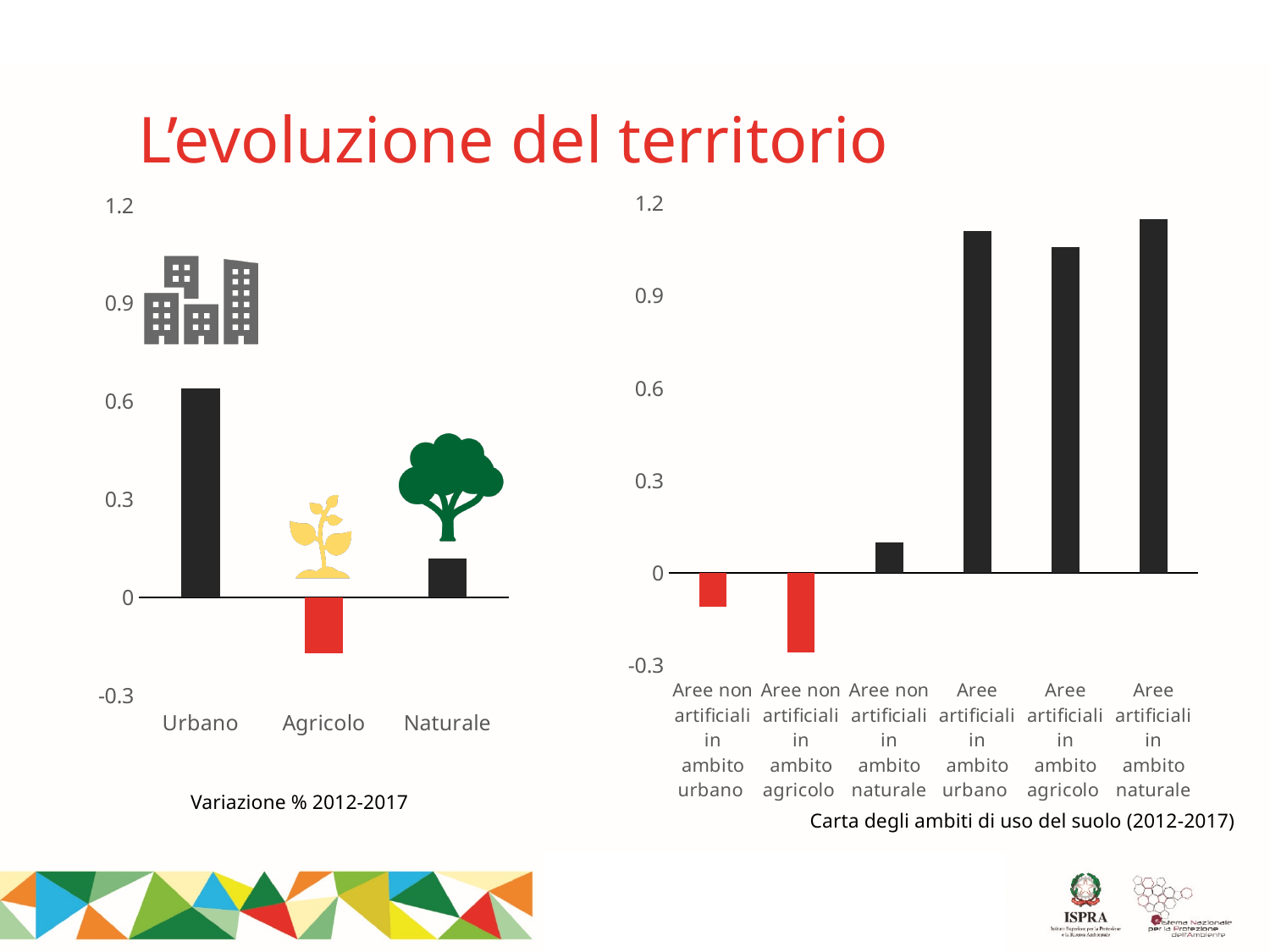
In the right chart 'Carta degli ambiti di uso del suolo (2012-2017)', is the value for 'Aree artificiali in ambito agricolo' greater or less than 0.9? greater In the left chart 'Variazione % 2012-2017', which category has the lowest value? Agricolo In the right chart 'Carta degli ambiti di uso del suolo (2012-2017)', is the value for 'Aree non artificiali in ambito naturale' greater or less than 0.3? less In the left chart 'Variazione % 2012-2017', is the value for Agricolo greater or less than 0? less In the left chart 'Variazione % 2012-2017', what colour is the bar for Agricolo? red In the right chart 'Carta degli ambiti di uso del suolo (2012-2017)', which is larger: the value for 'Aree artificiali in ambito urbano' or 'Aree non artificiali in ambito urbano'? Aree artificiali in ambito urbano In the left chart 'Variazione % 2012-2017', which category has the highest value? Urbano What kind of chart is the left chart titled 'Variazione % 2012-2017'? bar chart In the right chart 'Carta degli ambiti di uso del suolo (2012-2017)', how many categories are shown on the x axis? 6 In the right chart 'Carta degli ambiti di uso del suolo (2012-2017)', which category has the lowest value? Aree non artificiali in ambito agricolo In the left chart 'Variazione % 2012-2017', how many categories are shown on the x axis? 3